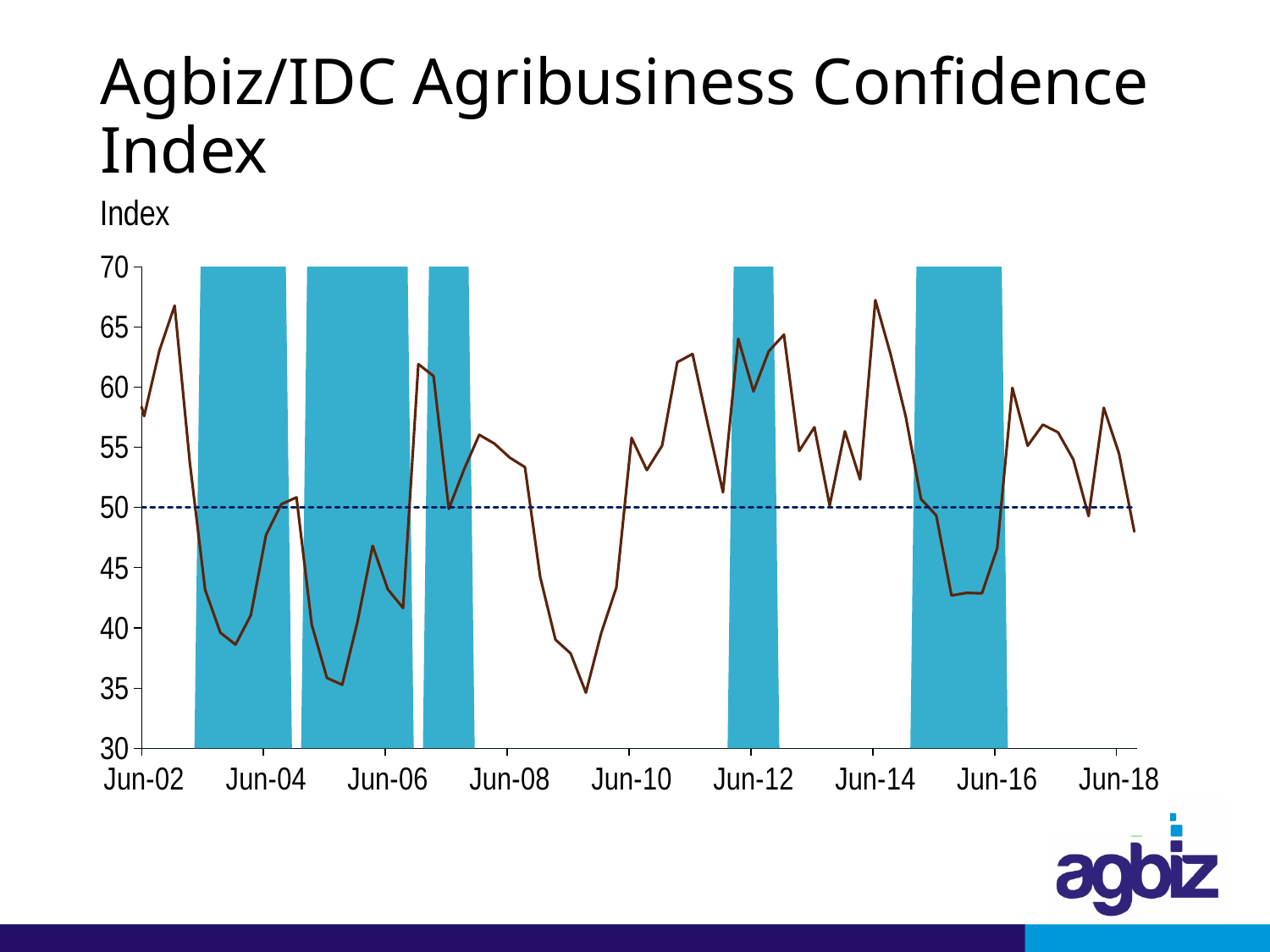
How many shaded blue regions are there on the chart? 5 At what level is the dashed horizontal reference line drawn on the chart? 50 Which is larger, the index value at Jun-02 or at Jun-18? Jun-02 What label is shown on the vertical axis of the chart? Index What is the title of the chart on the slide? Agbiz/IDC Agribusiness Confidence Index What kind of chart is shown on the slide? line chart Is the value of the index at Jun-18 greater or less than 50? greater How many date labels are shown along the x axis of the chart? 9 Overall, is the index higher or lower at Jun-18 than it was at Jun-02? lower Is the value of the index at Jun-02 greater or less than 55? greater